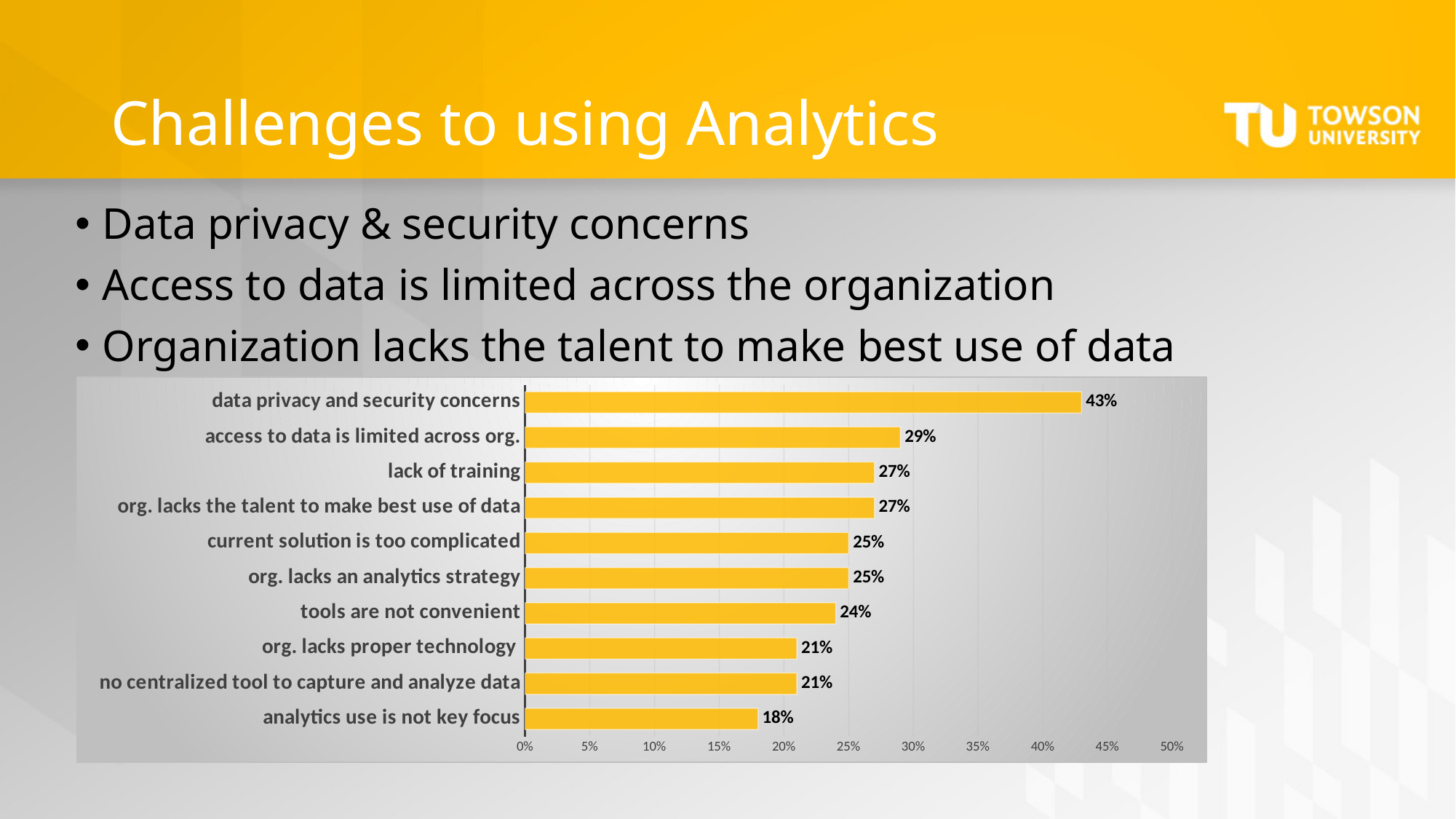
Which challenge has the highest percentage? data privacy and security concerns What value is shown for "tools are not convenient"? 24% Which challenge has the lowest percentage? analytics use is not key focus What is the maximum value shown on the horizontal axis? 50% What is the value for "lack of training"? 27% What kind of chart is shown on the slide? bar chart Which is larger: "org. lacks proper technology" or "tools are not convenient"? tools are not convenient How many challenges are plotted in the chart? 10 Is the value for "access to data is limited across org." greater or less than 25%? greater What is the value for "analytics use is not key focus"? 18% What is the difference between "data privacy and security concerns" and "access to data is limited across org."? 14% What percentage is shown for "data privacy and security concerns"? 43%